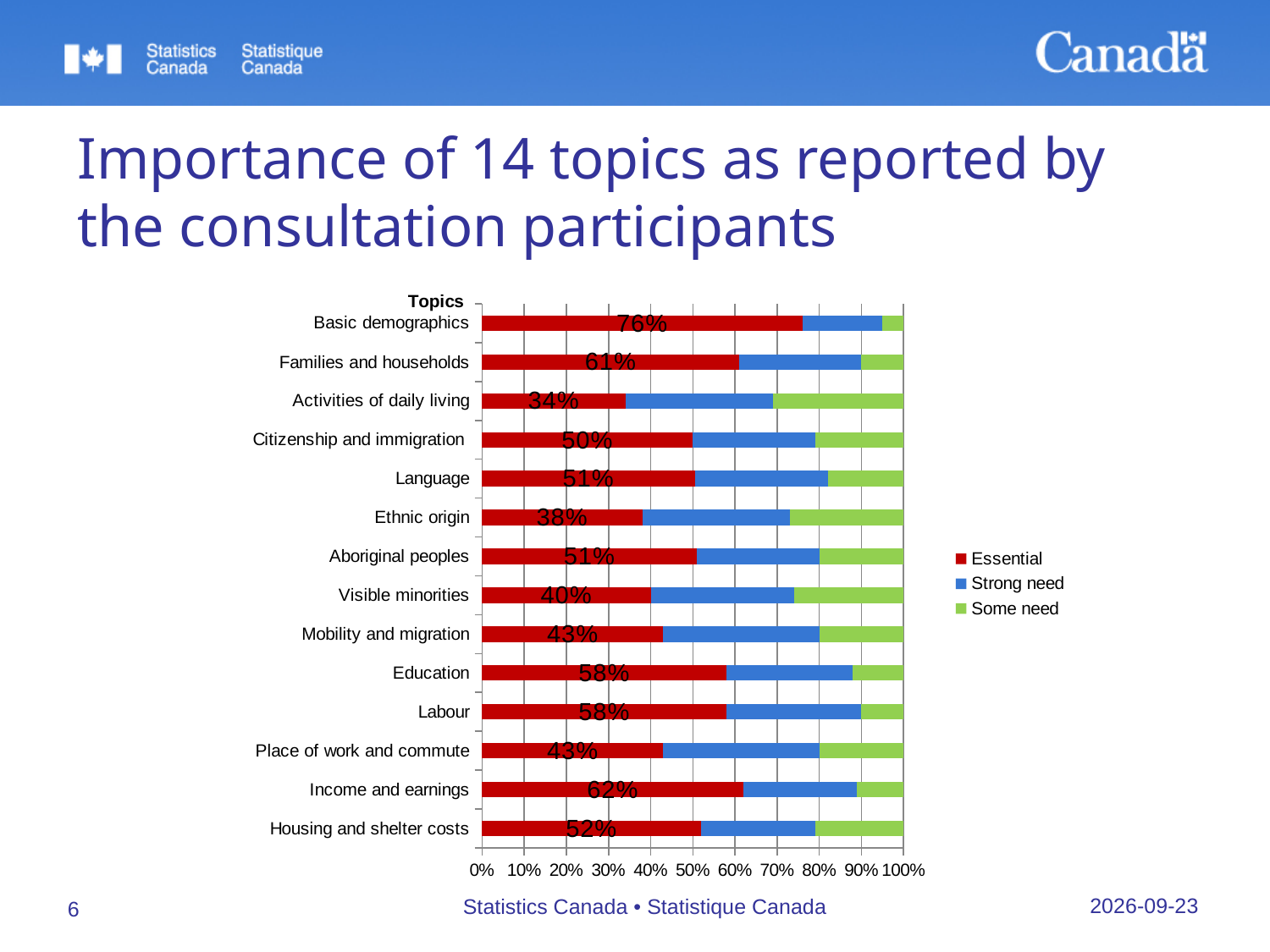
Is the Essential value for Visible minorities greater or less than 50%? less What is the difference between the Essential values for Basic demographics and Ethnic origin? 38% What kind of chart is shown on the slide? Stacked bar chart Which colour represents the Strong need series in the chart? Blue What is the Essential value for Income and earnings? 62% Which has a larger Essential value, Families and households or Housing and shelter costs? Families and households How many series does the legend list? 3 What percentage of participants rated Basic demographics as Essential? 76% Which topic has the lowest Essential percentage? Activities of daily living What is the Essential value for Activities of daily living? 34% How many topics are shown in the chart? 14 Which topic has the highest Essential percentage? Basic demographics